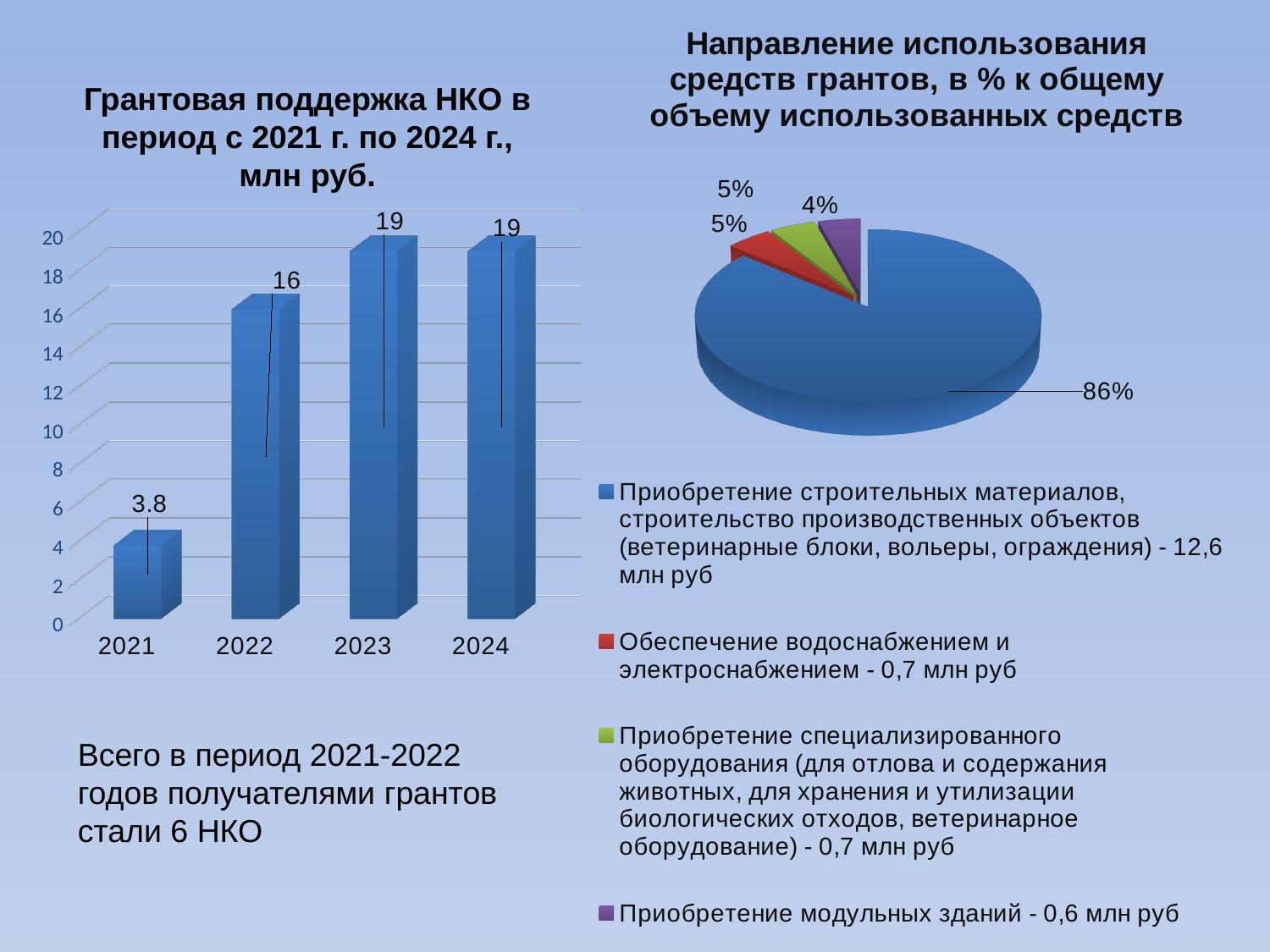
In the bar chart 'Грантовая поддержка НКО', do the values rise or fall from 2021 to 2023? rise In the bar chart 'Грантовая поддержка НКО', what is the value for 2021? 3.8 In the bar chart 'Грантовая поддержка НКО', what is the value for 2024? 19 In the bar chart 'Грантовая поддержка НКО', which year has the lowest value? 2021 In the bar chart 'Грантовая поддержка НКО', which is larger, the value for 2022 or the value for 2021? 2022 In the bar chart 'Грантовая поддержка НКО', how many years are shown on the x axis? 4 In the pie chart 'Направление использования средств грантов', what share does 'Приобретение строительных материалов, строительство производственных объектов' have? 86% How many entries does the legend of the pie chart 'Направление использования средств грантов' list? 4 In the pie chart 'Направление использования средств грантов', what share does 'Приобретение модульных зданий' have? 4% What type of chart is the left chart 'Грантовая поддержка НКО'? bar chart In the bar chart 'Грантовая поддержка НКО', what is the value for 2022? 16 In the bar chart 'Грантовая поддержка НКО', what is the difference between the values for 2023 and 2022? 3